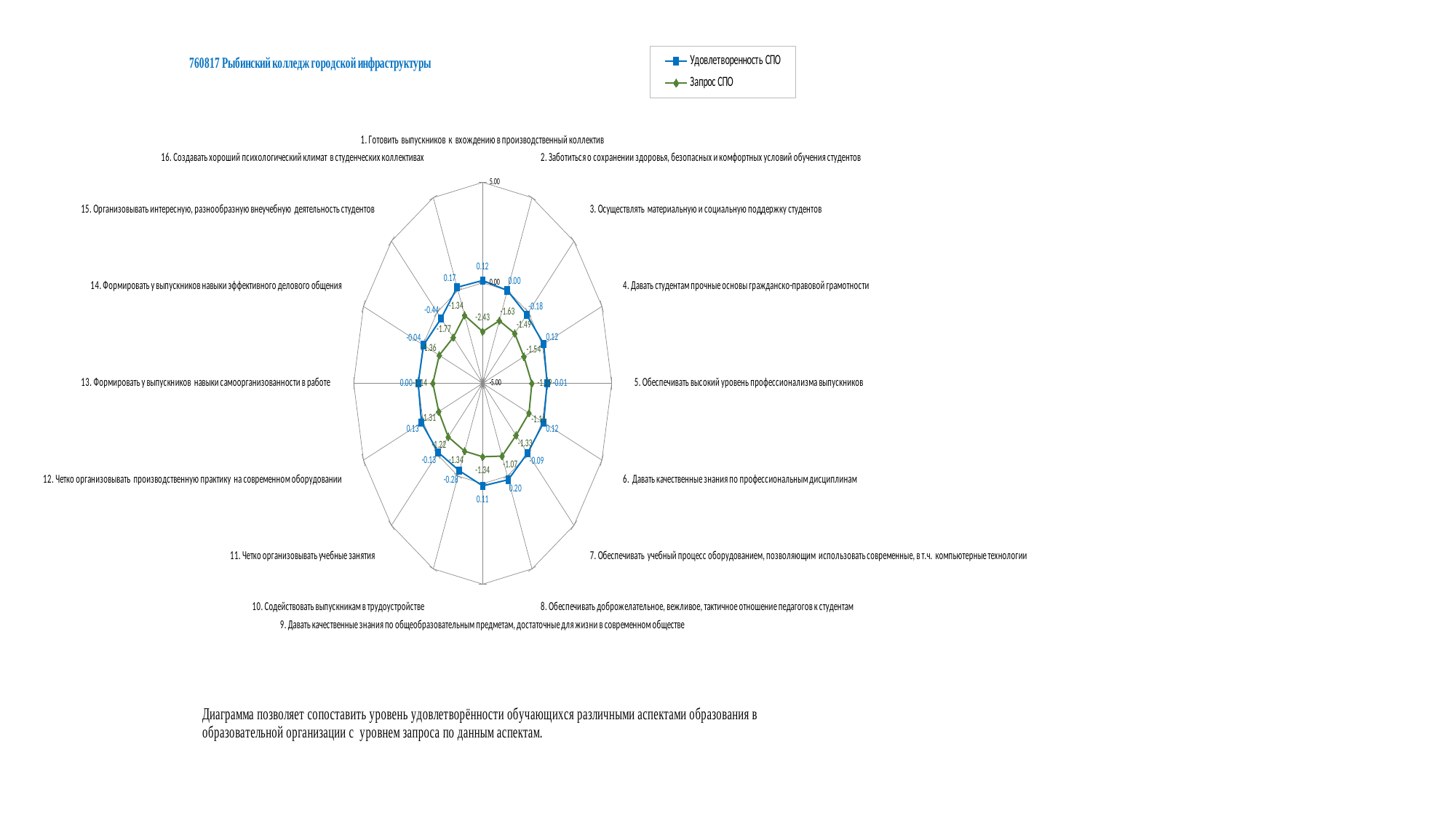
What is the Запрос СПО value for category 15 (Организовывать интересную, разнообразную внеучебную деятельность студентов)? -1.77 What is the Удовлетворенность СПО value for category 15 (Организовывать интересную, разнообразную внеучебную деятельность студентов)? -0.44 Which category has the lowest Удовлетворенность СПО value? 15. Организовывать интересную, разнообразную внеучебную деятельность студентов What kind of chart is shown on the slide? Radar chart What are the two series named in the legend? Удовлетворенность СПО and Запрос СПО What is the Удовлетворенность СПО value for category 8 (Обеспечивать доброжелательное, вежливое, тактичное отношение педагогов к студентам)? 0.20 For category 8, which series has the larger value, Удовлетворенность СПО or Запрос СПО? Удовлетворенность СПО What is the title of the chart? 760817 Рыбинский колледж городской инфраструктуры How many series does the legend list? 2 What is the Удовлетворенность СПО value for category 10 (Содействовать выпускникам в трудоустройстве)? -0.28 What is the Запрос СПО value for category 8 (Обеспечивать доброжелательное, вежливое, тактичное отношение педагогов к студентам)? -1.07 How many categories (axes) does the radar chart have? 16